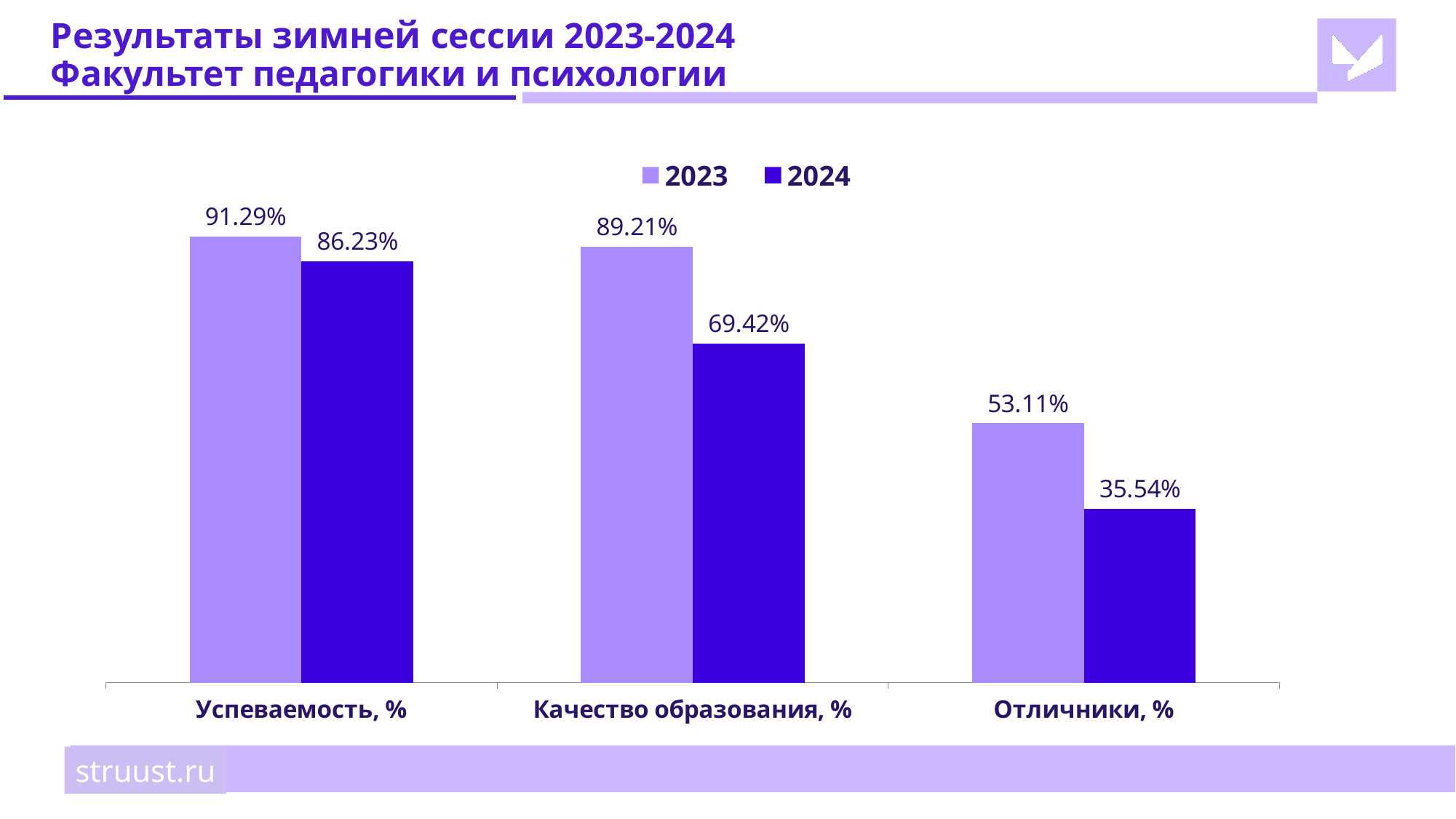
What kind of chart is shown on the slide? Bar chart What is the 2023 value for Успеваемость, %? 91.29% What is the 2023 value for Отличники, %? 53.11% Which category has the highest 2023 value? Успеваемость, % How many categories are shown on the x axis? 3 What is the difference between the 2023 and 2024 values for Отличники, %? 17.57% What is the 2024 value for Отличники, %? 35.54% How many series does the legend list? 2 Which category has the lowest 2024 value? Отличники, % What is the 2024 value for Качество образования, %? 69.42% Which is larger for Успеваемость, %: the 2023 value or the 2024 value? 2023 What is the difference between the 2023 and 2024 values for Качество образования, %? 19.79%